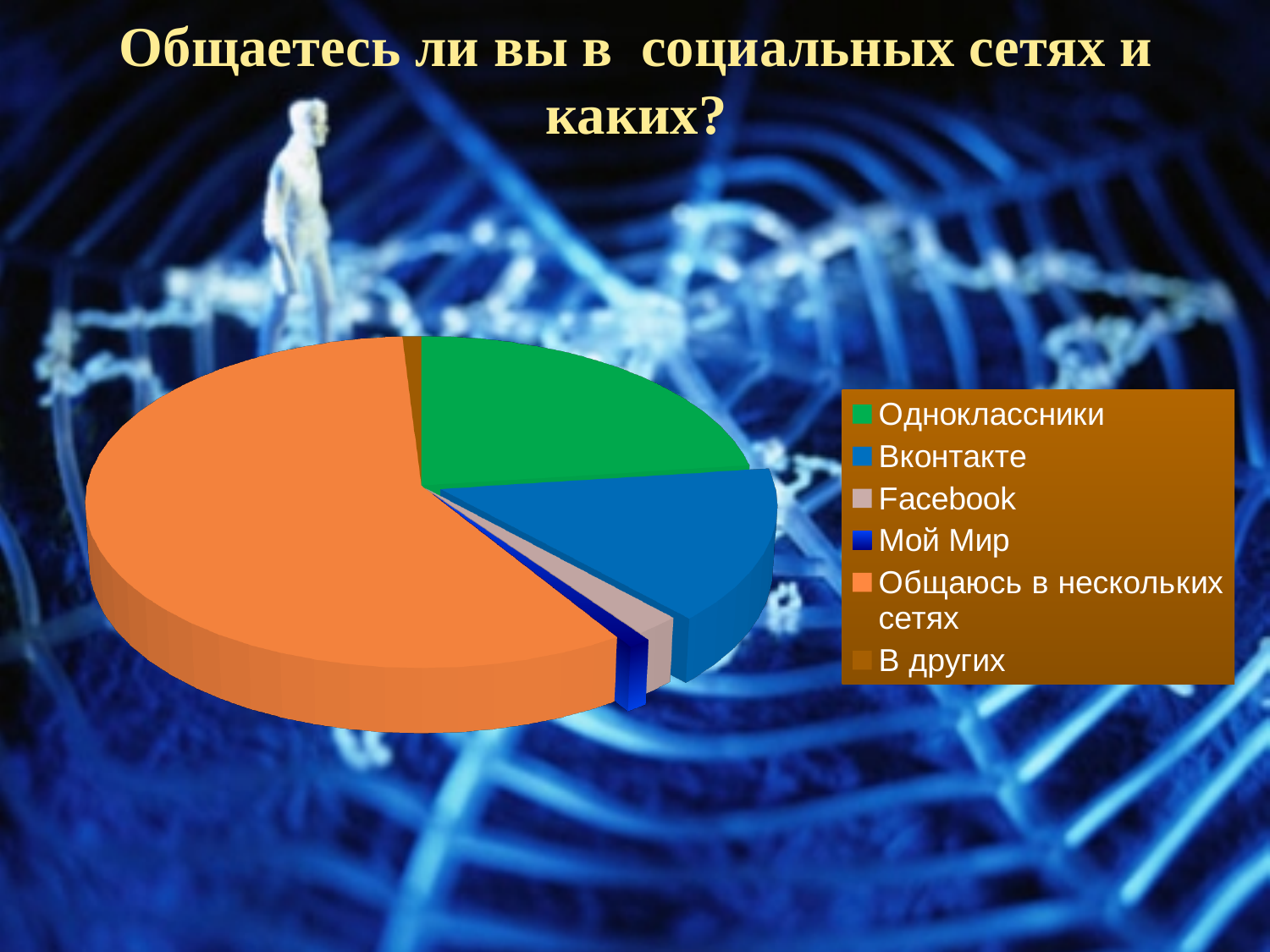
Which category has the largest slice of the pie? Общаюсь в нескольких сетях What is the title of the slide containing the pie chart? Общаетесь ли вы в социальных сетях и каких? What kind of chart is shown on the slide? pie chart Which slice is larger, Общаюсь в нескольких сетях or Одноклассники? Общаюсь в нескольких сетях Which slice is larger, Вконтакте or Facebook? Вконтакте Which slice is larger, Facebook or Общаюсь в нескольких сетях? Общаюсь в нескольких сетях How many categories does the pie chart's legend list? 6 What colour is the Одноклассники slice in the pie chart? green